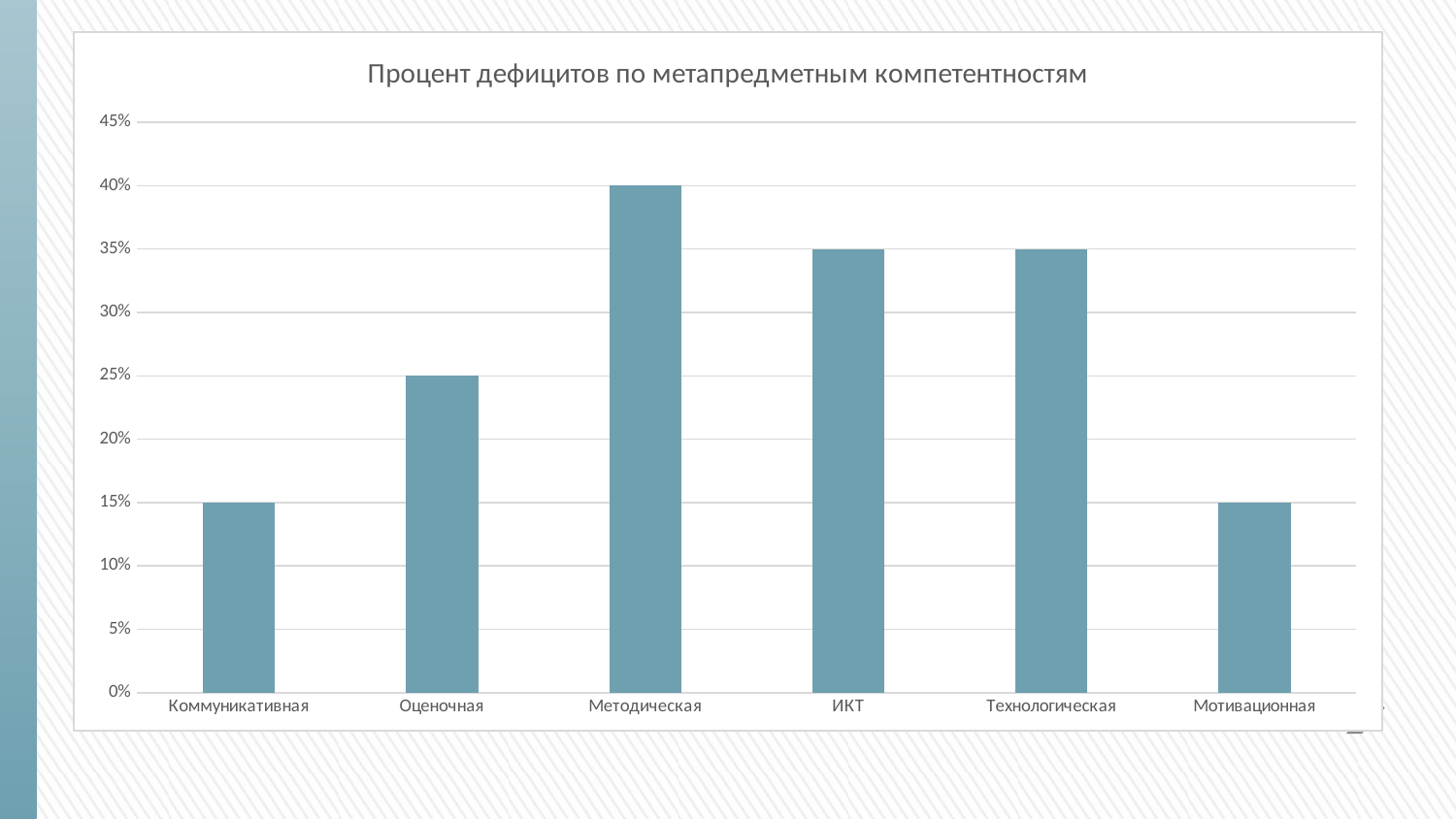
What is the highest value shown on the y axis? 45% What is the value for ИКТ? 35% What kind of chart is shown on the slide? bar chart What is the value for Методическая? 40% What is the title of the chart? Процент дефицитов по метапредметным компетентностям What is the value for Оценочная? 25% Which is larger, the value for Оценочная or the value for Мотивационная? Оценочная Is the value for Технологическая greater or less than 30%? greater What is the value for Коммуникативная? 15% How many categories are shown on the x axis? 6 Which category has the highest value? Методическая What is the difference between the values for Методическая and Оценочная? 15%